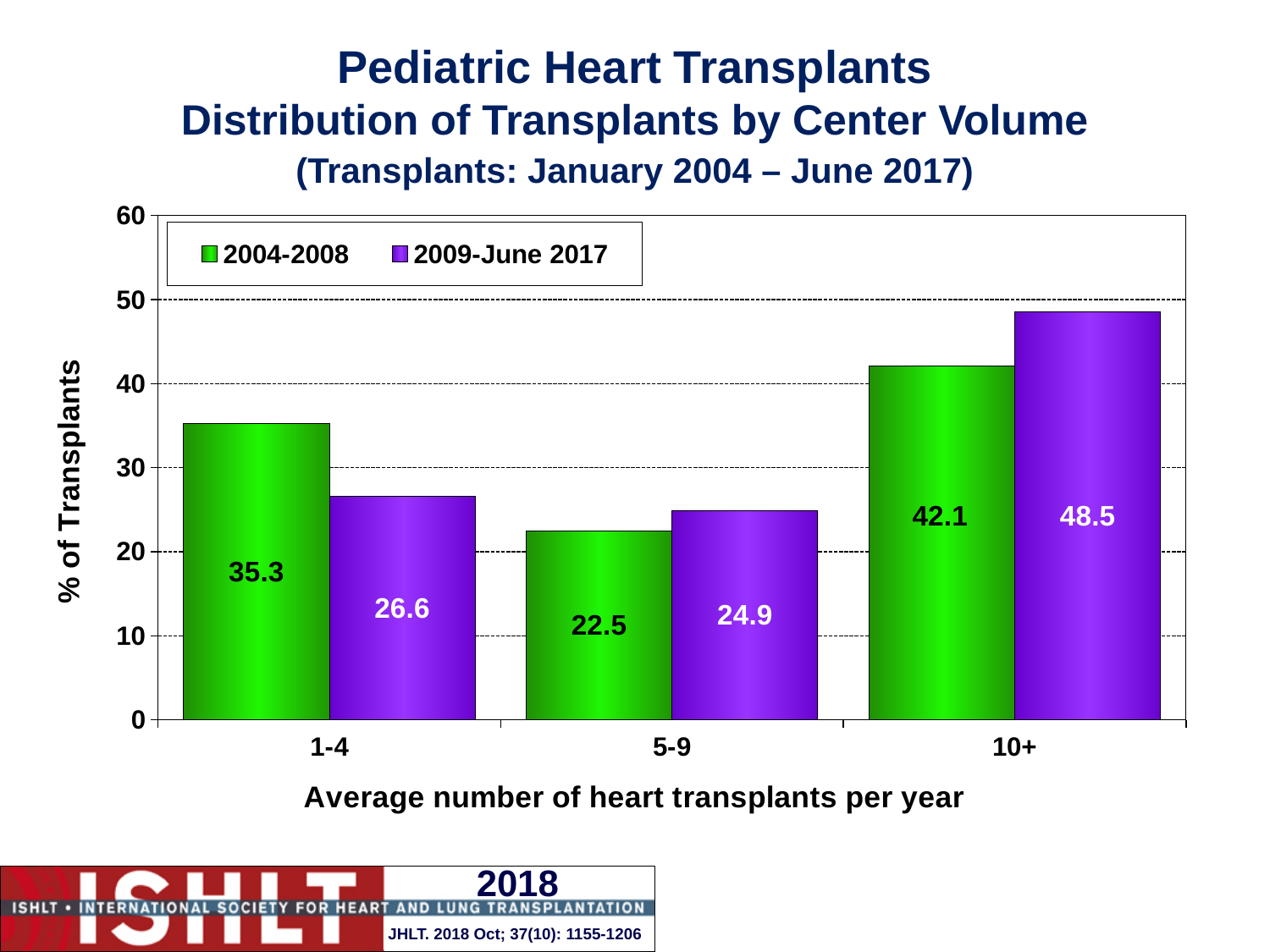
What is the value for the 2009-June 2017 series in the 10+ category? 48.5 What is the value for the 2009-June 2017 series in the 5-9 category? 24.9 What is the label of the y axis? % of Transplants Which category has the lowest value for the 2009-June 2017 series? 5-9 Is the value for the 2004-2008 series in the 5-9 category greater or less than 30? less What is the value for the 2004-2008 series in the 1-4 category? 35.3 How many series does the legend list? 2 In the 1-4 category, which series has the larger value, 2004-2008 or 2009-June 2017? 2004-2008 What is the difference between the 2009-June 2017 and 2004-2008 values in the 10+ category? 6.4 How many categories are shown on the x axis? 3 What kind of chart is shown on the slide? bar chart Which category has the highest value for the 2004-2008 series? 10+